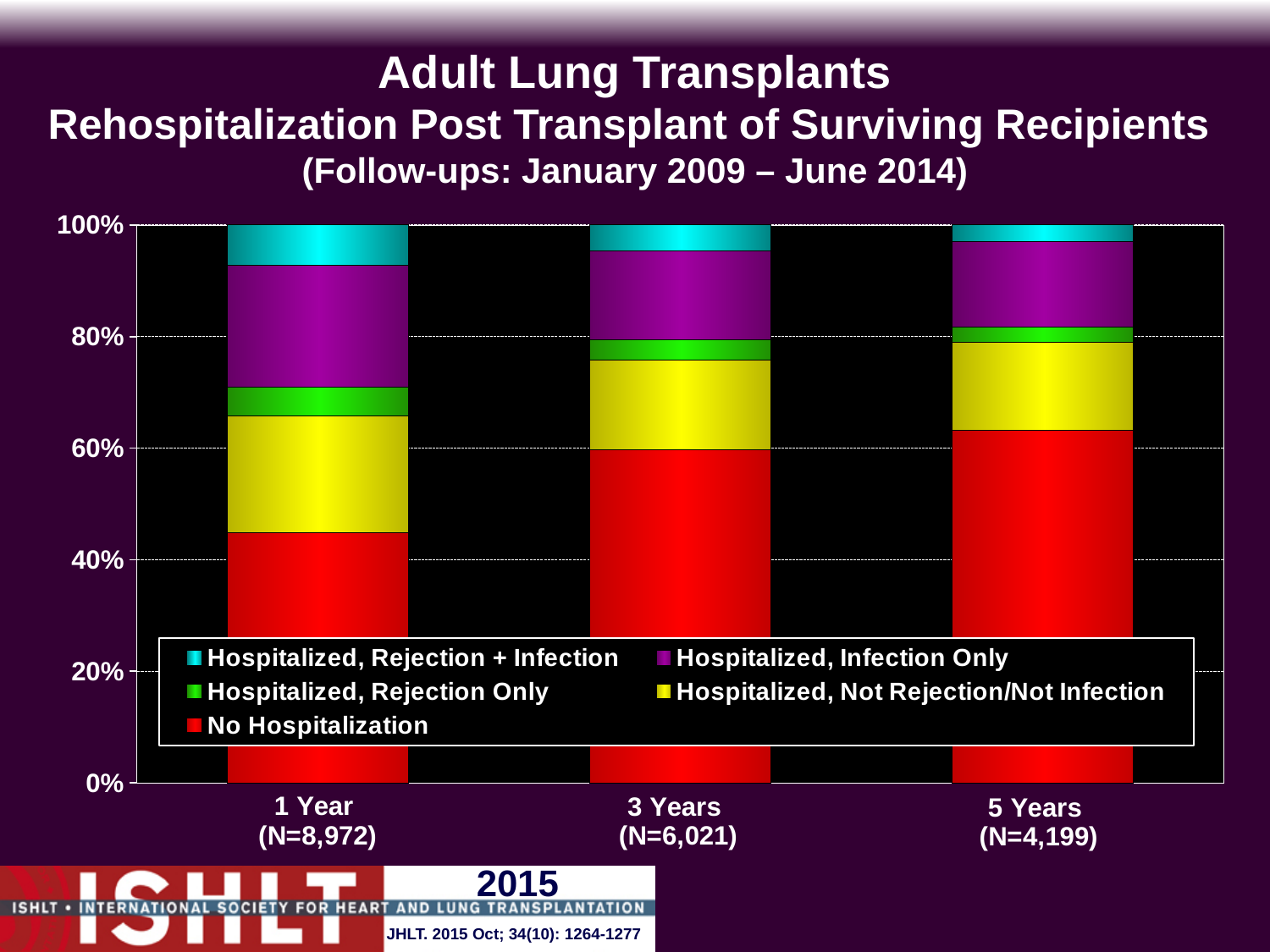
How many series does the legend list? 5 Which is larger: the Hospitalized, Infection Only share at 1 Year or at 5 Years? 1 Year How many follow-up time points (categories) are shown on the x axis? 3 Is the No Hospitalization share at 1 Year greater or less than 60%? less Is the No Hospitalization share at 5 Years greater or less than 40%? greater What is the N shown for the 3 Years category? N=6,021 Is the No Hospitalization share at 1 Year greater or less than 40%? greater What kind of chart is shown on the slide? Stacked bar chart Does the Hospitalized, Rejection + Infection share rise or fall from 1 Year to 5 Years? Fall Does the share of No Hospitalization rise or fall from 1 Year to 5 Years? Rise Which follow-up time point has the lowest share of No Hospitalization? 1 Year What is the total height of each stacked bar on the y axis? 100%